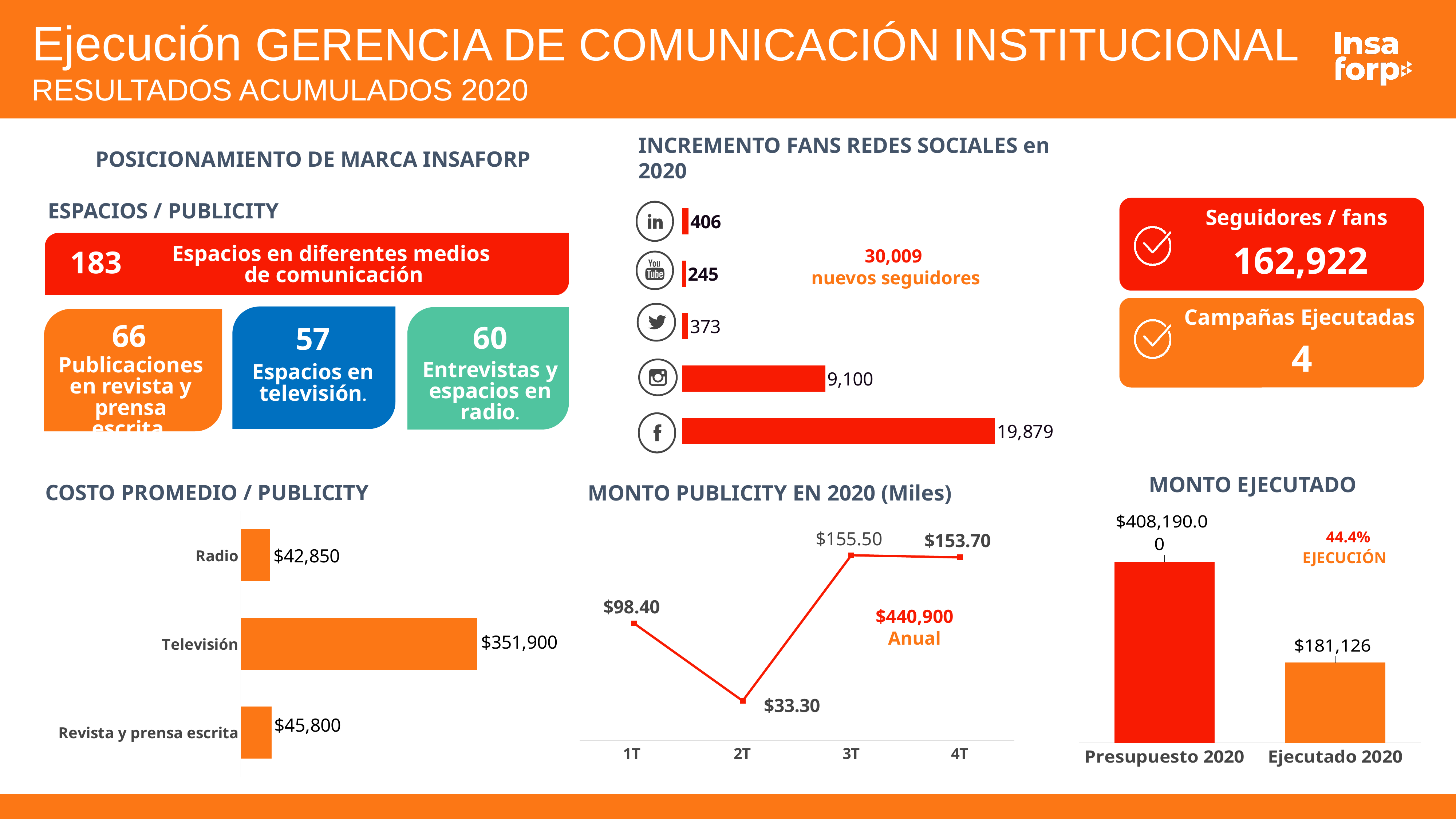
In the INCREMENTO FANS REDES SOCIALES en 2020 chart, what is the value for Facebook? 19,879 In the INCREMENTO FANS REDES SOCIALES en 2020 chart, what is the difference between Facebook and Instagram? 10,779 In the MONTO PUBLICITY EN 2020 (Miles) chart, how many quarters are plotted? 4 In the COSTO PROMEDIO / PUBLICITY chart, what is the value for Televisión? $351,900 What kind of chart is the COSTO PROMEDIO / PUBLICITY chart? Bar chart In the MONTO PUBLICITY EN 2020 (Miles) chart, what is the value for 2T? $33.30 In the COSTO PROMEDIO / PUBLICITY chart, which category has the lowest value? Radio In the MONTO EJECUTADO chart, which is larger, Presupuesto 2020 or Ejecutado 2020? Presupuesto 2020 In the MONTO EJECUTADO chart, what is the value for Ejecutado 2020? $181,126 In the COSTO PROMEDIO / PUBLICITY chart, what is the difference between Revista y prensa escrita and Radio? $2,950 In the MONTO PUBLICITY EN 2020 (Miles) chart, does the value rise or fall from 1T to 2T? Fall In the MONTO PUBLICITY EN 2020 (Miles) chart, which quarter has the highest value? 3T